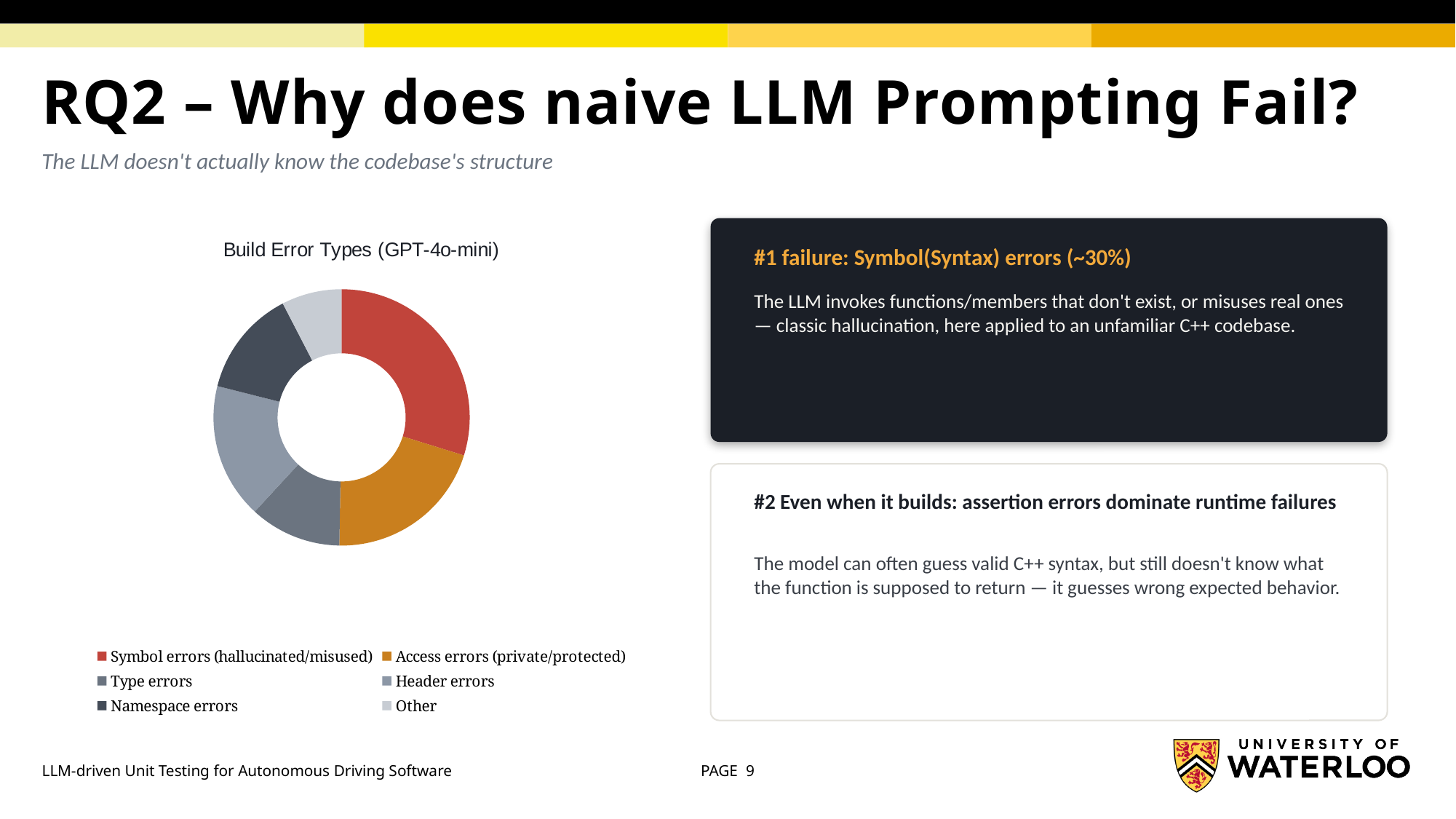
Which slice is larger: Symbol errors (hallucinated/misused) or Header errors? Symbol errors (hallucinated/misused) What colour represents Access errors (private/protected) in the chart? Orange Which slice is larger: Access errors (private/protected) or Other? Access errors (private/protected) Which slice is larger: Symbol errors (hallucinated/misused) or Other? Symbol errors (hallucinated/misused) Which error type has the smallest slice in the chart? Other What kind of chart is shown on the slide? Pie chart (donut) What is the title of the chart? Build Error Types (GPT-4o-mini) Which error type has the largest slice in the chart? Symbol errors (hallucinated/misused) How many error categories does the chart's legend list? 6